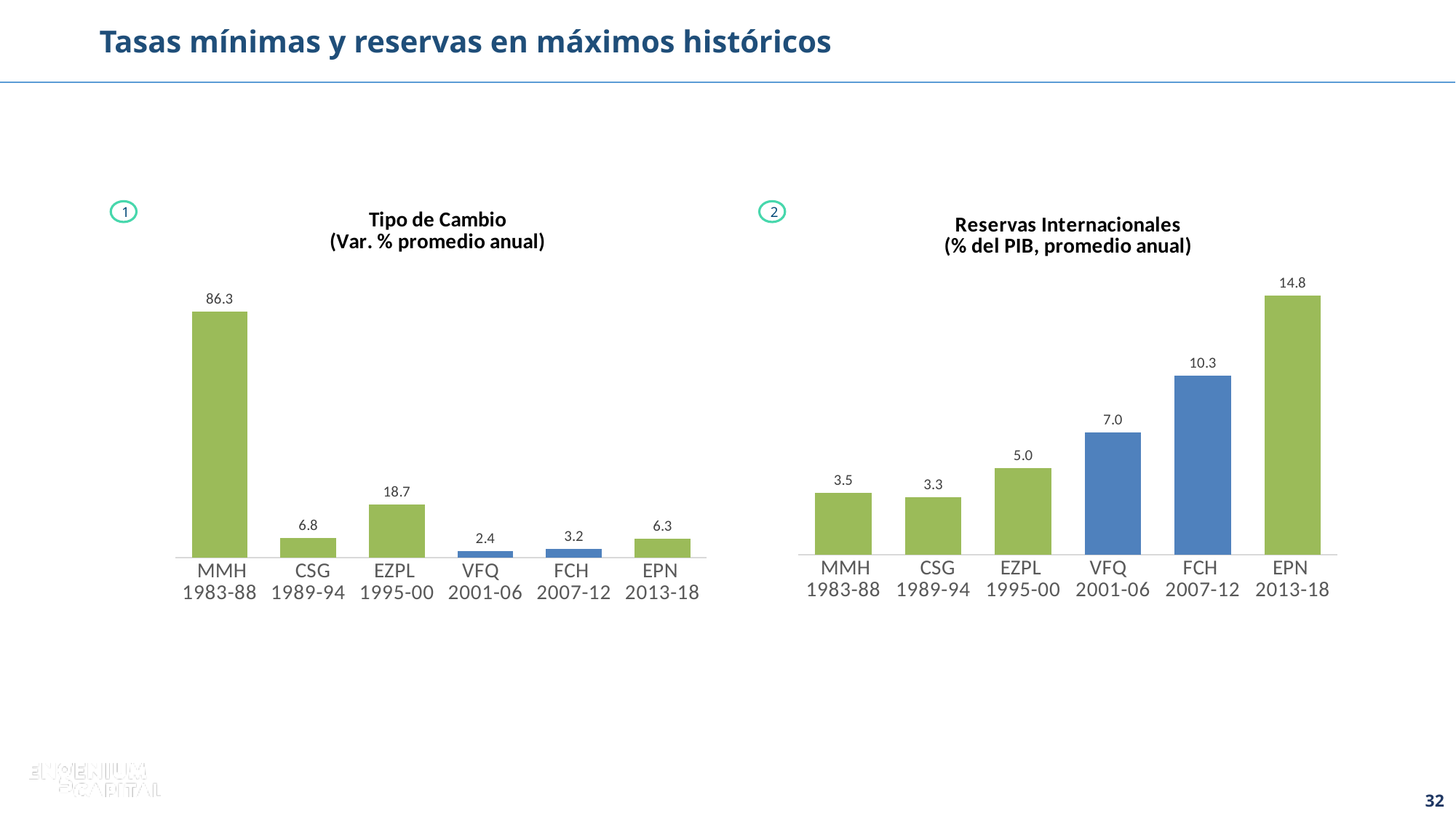
In the 'Reservas Internacionales' chart, which category has the lowest value? CSG 1989-94 In the 'Tipo de Cambio' chart, which bars are coloured blue? VFQ 2001-06 and FCH 2007-12 In the 'Tipo de Cambio' chart, which category has the lowest value? VFQ 2001-06 How many categories are shown in the 'Tipo de Cambio' chart? 6 In the 'Tipo de Cambio' chart, which is larger, the value for FCH 2007-12 or the value for EPN 2013-18? EPN 2013-18 In the 'Reservas Internacionales' chart, what is the value for FCH 2007-12? 10.3 In the 'Tipo de Cambio' chart, what is the difference between the values for EZPL 1995-00 and CSG 1989-94? 11.9 In the 'Tipo de Cambio' chart, what is the value for MMH 1983-88? 86.3 In the 'Reservas Internacionales' chart, do the values generally rise or fall from MMH 1983-88 to EPN 2013-18? Rise In the 'Reservas Internacionales' chart, which category has the highest value? EPN 2013-18 What kind of chart is the 'Reservas Internacionales' chart? Bar chart In the 'Reservas Internacionales' chart, what is the difference between the values for EPN 2013-18 and VFQ 2001-06? 7.8